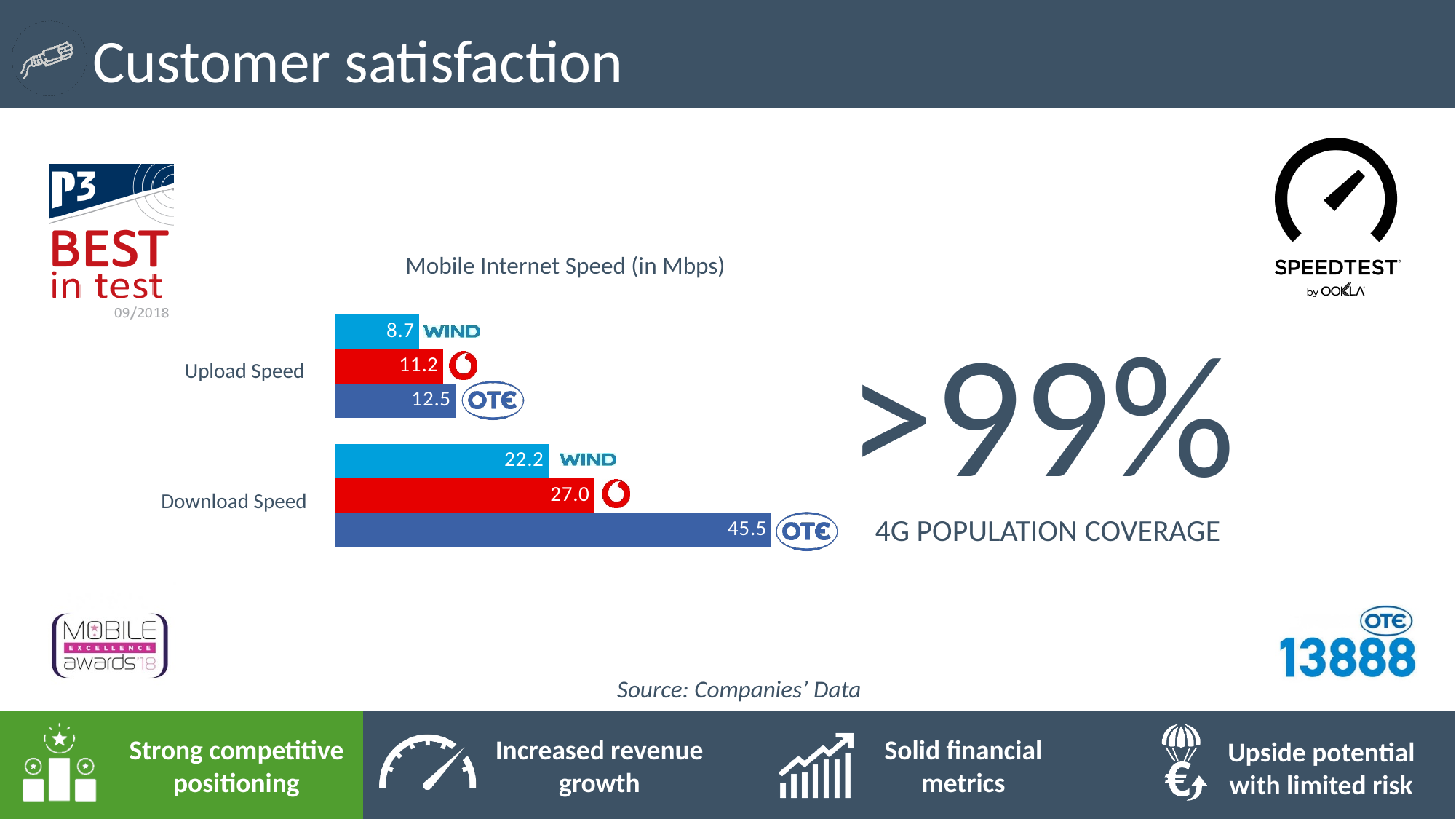
In the Mobile Internet Speed chart, which operator has the highest Download Speed? OTE What type of chart is used to show Mobile Internet Speed? bar chart How many speed categories are shown in the Mobile Internet Speed chart? 2 In the Mobile Internet Speed chart, which is larger: the red bar's Download Speed or WIND's Download Speed? the red bar's Download Speed In the Mobile Internet Speed chart, what is the difference between OTE's Upload Speed and WIND's Upload Speed? 3.8 In the Mobile Internet Speed chart, which operator has the lowest Upload Speed? WIND In the Mobile Internet Speed chart, what is the Upload Speed for WIND? 8.7 What is the title of the chart on the slide? Mobile Internet Speed (in Mbps) In the Mobile Internet Speed chart, what is the Upload Speed for OTE? 12.5 In the Mobile Internet Speed chart, what is the Download Speed for WIND? 22.2 In the Mobile Internet Speed chart, what is the Download Speed for OTE? 45.5 In the Mobile Internet Speed chart, what is the difference between OTE's Download Speed and WIND's Download Speed? 23.3